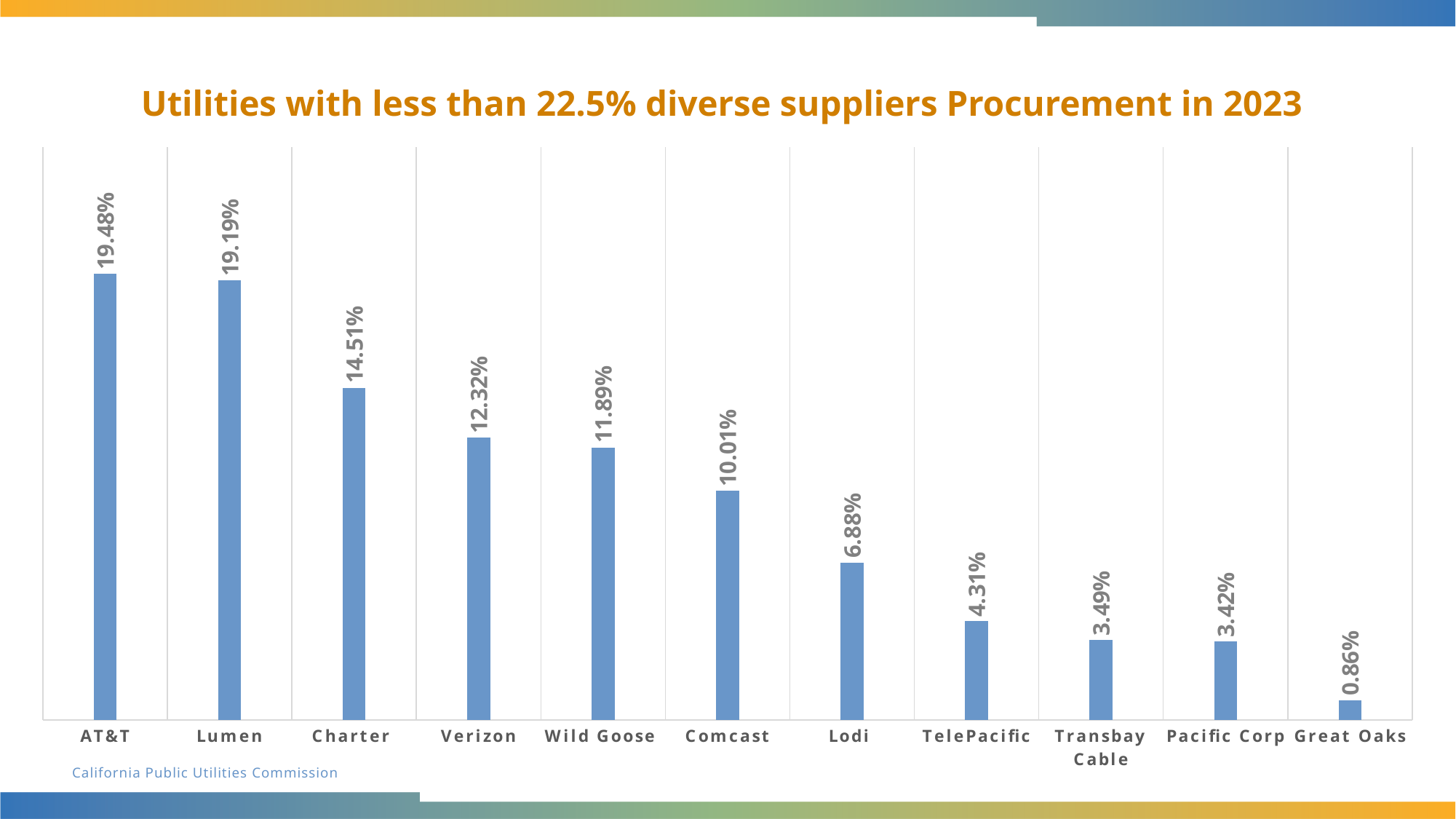
What is the value for Transbay Cable? 3.49% What is the value for Lodi? 6.88% What is the title of the chart? Utilities with less than 22.5% diverse suppliers Procurement in 2023 What kind of chart is shown on the slide? Bar chart What is the difference between the values for Verizon and Wild Goose? 0.43% What is the difference between the values for AT&T and Lumen? 0.29% What is the value for Charter? 14.51% Do the values rise or fall from left to right across the chart? Fall Which utility has the lowest value? Great Oaks How many utilities are shown in the chart? 11 Which utility has the highest value? AT&T Which is larger, the value for Comcast or the value for Lodi? Comcast